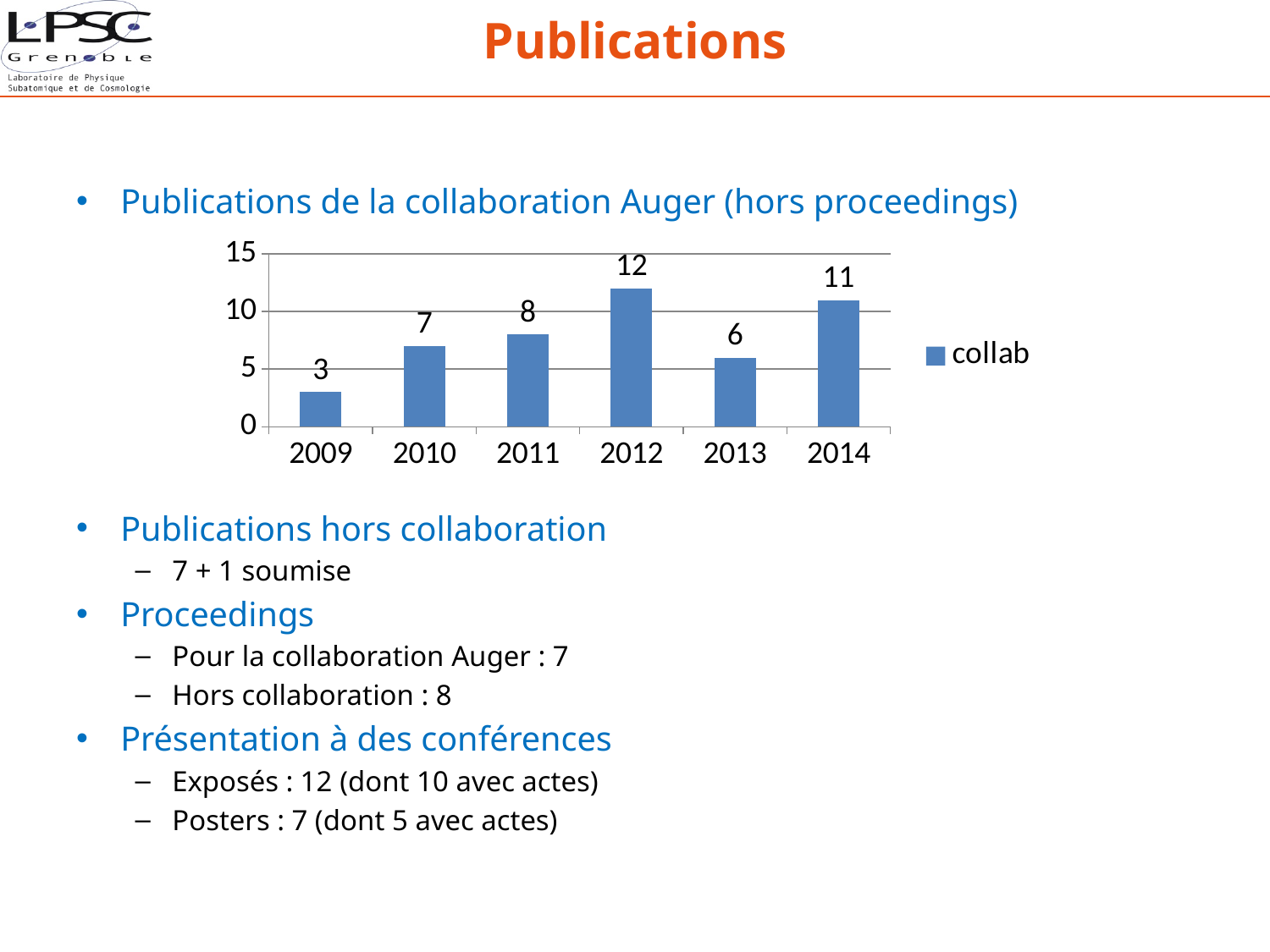
How many years are shown on the x axis? 6 Which year has the lowest value? 2009 Which is larger, the value for 2010 or the value for 2014? 2014 What is the value for 2013? 6 What kind of chart is shown? bar chart What is the value for 2009? 3 Which year has the highest value? 2012 What is the name of the series in the legend? collab How many series does the legend list? 1 What is the difference between the values for 2012 and 2013? 6 Is the value for 2011 greater or less than 10? less What is the value for 2012? 12